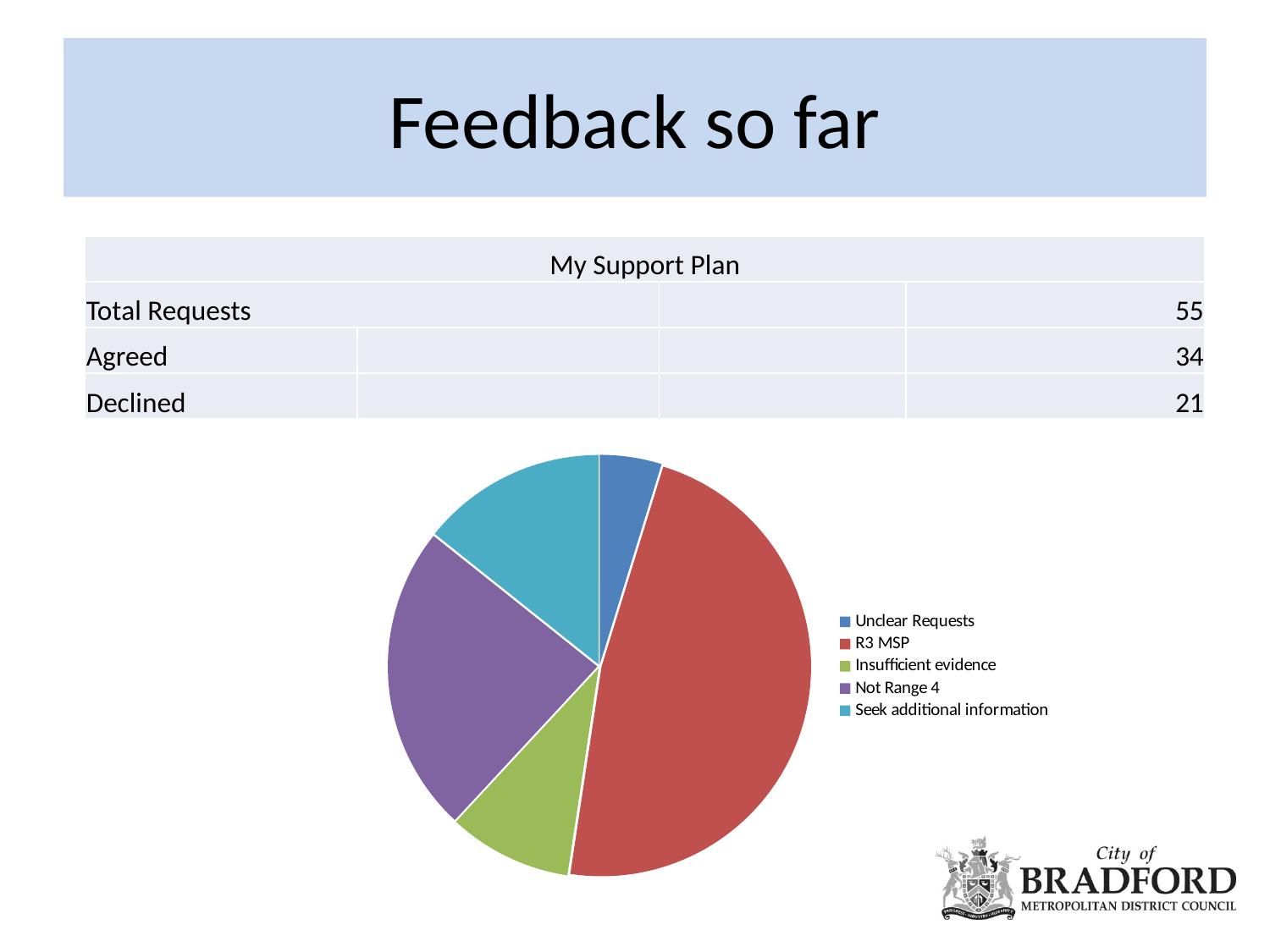
Which slice is larger in the pie chart, R3 MSP or Not Range 4? R3 MSP What colour is the R3 MSP slice in the pie chart? red What kind of chart is shown on the slide? pie chart Which slice is larger in the pie chart, Insufficient evidence or Unclear Requests? Insufficient evidence Which category has the largest slice of the pie chart? R3 MSP How many slices does the pie chart have? 5 Which legend entry is listed last in the pie chart's legend? Seek additional information Which slice is larger in the pie chart, Seek additional information or Insufficient evidence? Seek additional information Which category has the smallest slice of the pie chart? Unclear Requests Which category has the second-largest slice of the pie chart? Not Range 4